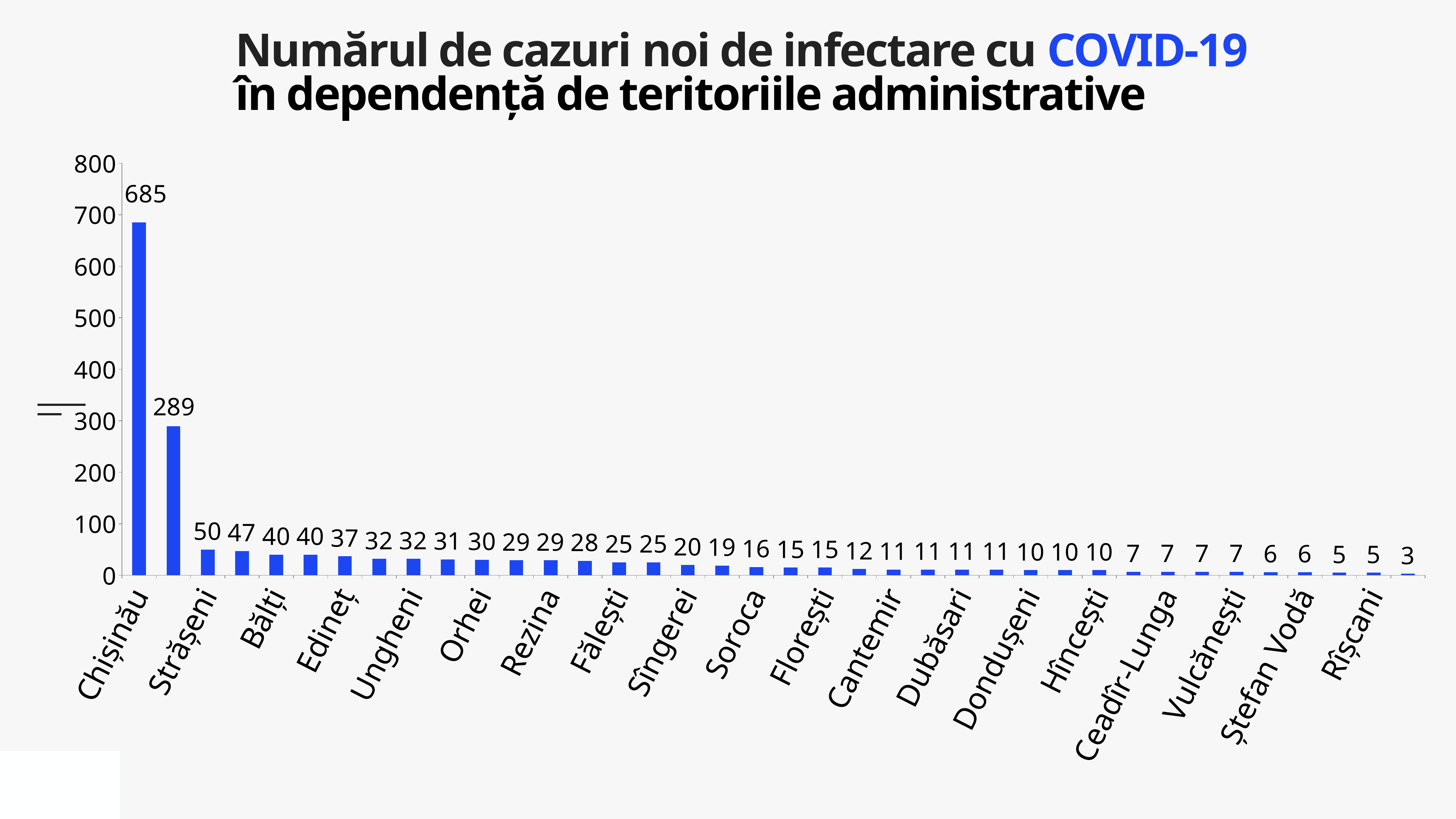
Do the values rise or fall from left to right along the x axis? fall What is the value shown for Chișinău? 685 What is the difference between the highest value (685) and the second highest value (289)? 396 What is the highest value shown on the chart? 685 What is the highest tick value on the vertical axis? 800 How many bars are plotted on the chart? 38 What is the second highest value shown on the chart? 289 Is the value for Chișinău greater or less than 600? greater What type of chart is shown on the slide? bar chart Which territory has the highest number of new cases? Chișinău What is the lowest value shown on the chart? 3 What colour are the bars on the chart? blue